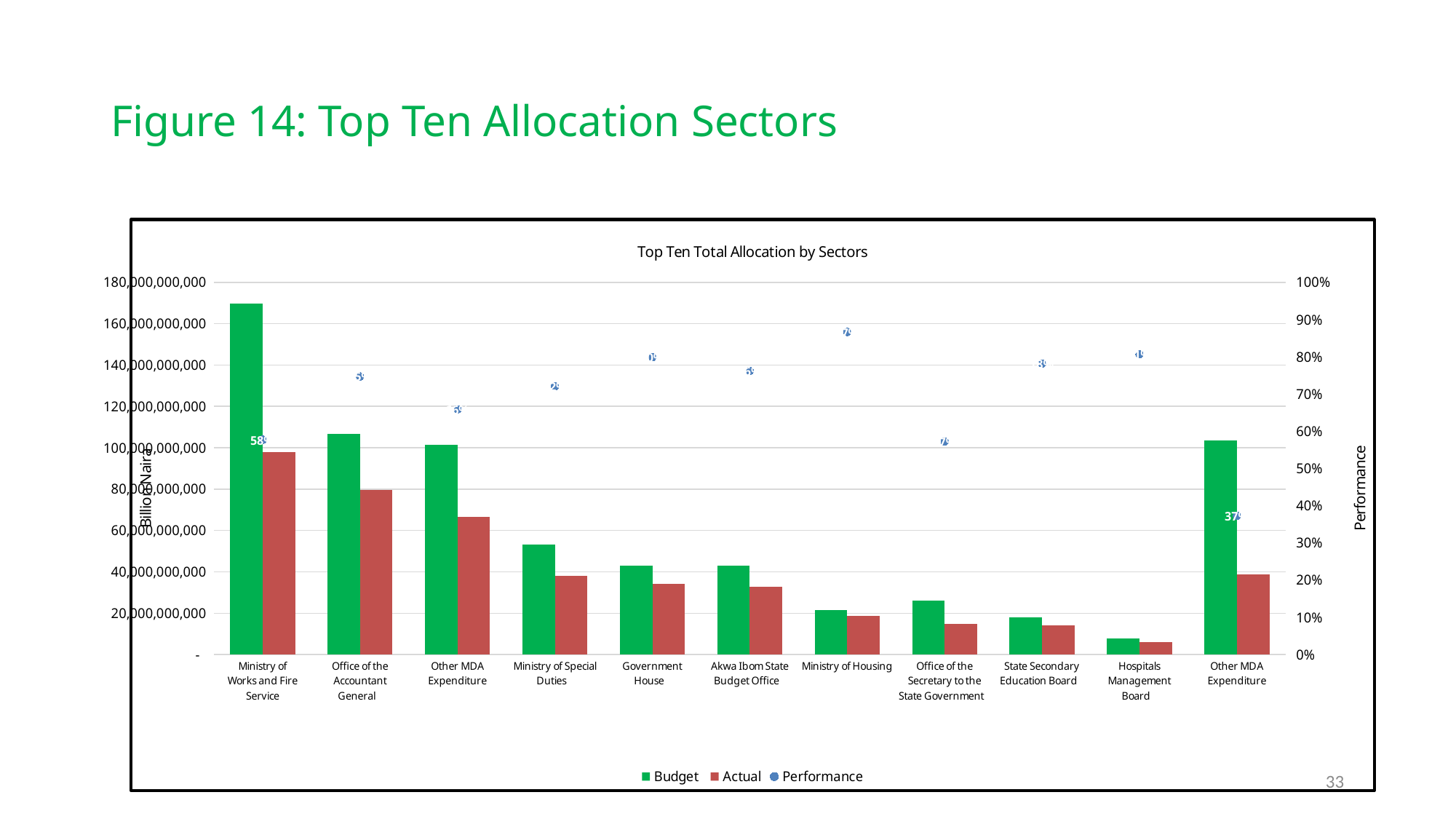
What kind of chart is used to show the Budget and Actual series? Bar chart What is the label on the right-hand vertical axis of the chart? Performance How many sector categories are shown along the x axis of the chart? 11 Which sector has the lowest Budget bar? Hospitals Management Board Which sector has the highest Budget bar? Ministry of Works and Fire Service Is the Budget value for Ministry of Works and Fire Service greater or less than 160,000,000,000? greater Which is larger for Office of the Secretary to the State Government: the Budget bar or the Actual bar? Budget Is the Actual value for Office of the Accountant General greater or less than 100,000,000,000? less Which sector has the highest Performance point? Ministry of Housing What is the title of the chart on the slide? Top Ten Total Allocation by Sectors How many series does the chart legend list? 3 Is the Performance value for Ministry of Housing greater or less than 80%? greater